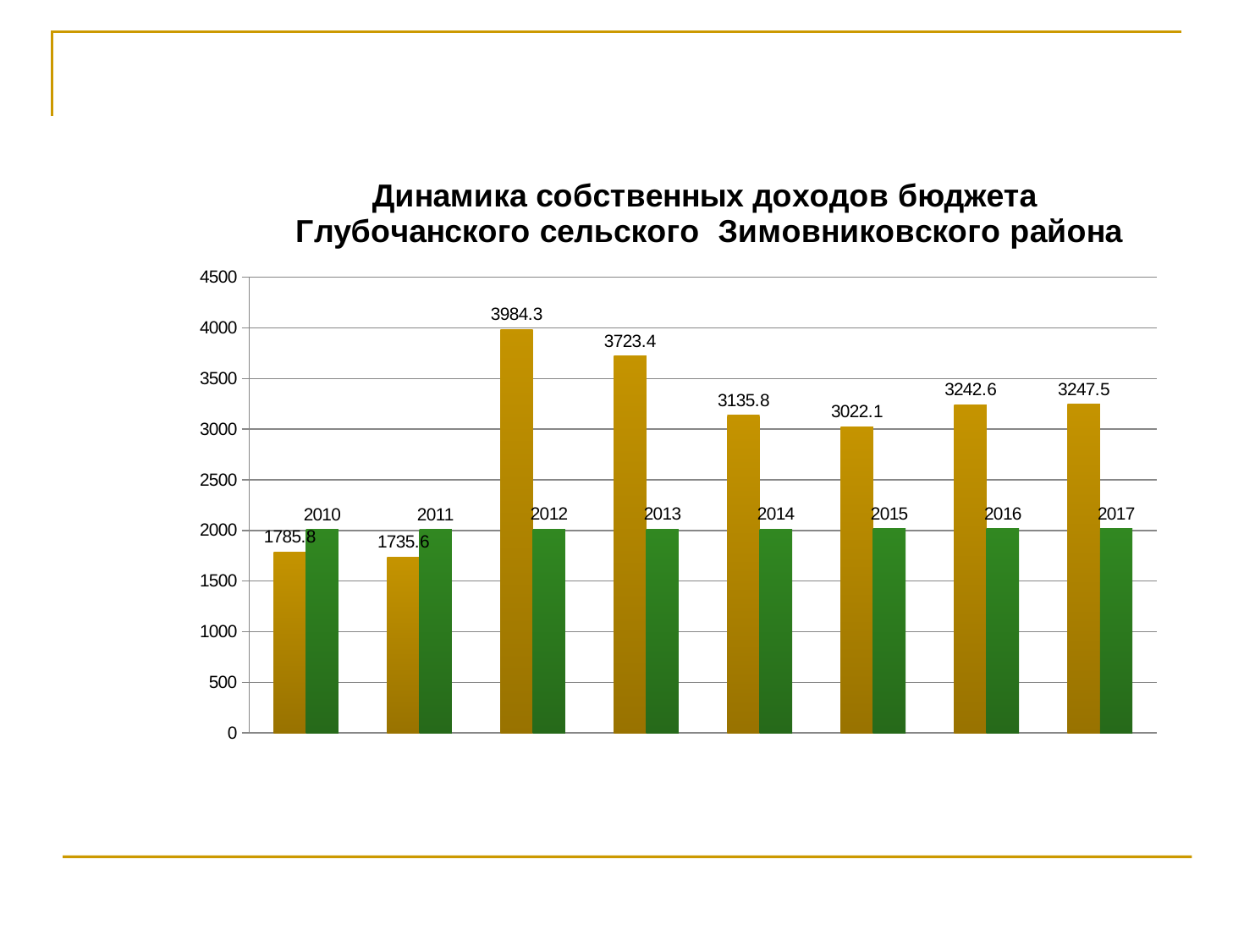
In which year group is the gold bar the lowest? 2011 How many year groups are plotted on the chart? 8 What value is printed on the gold bar in the 2010 group? 1785.8 What value is printed on the gold bar in the 2012 group? 3984.3 In which year group is the gold bar the highest? 2012 What value is printed on the gold bar in the 2015 group? 3022.1 Which gold bar is larger, the one for 2013 or the one for 2014? 2013 What is the title of the chart? Динамика собственных доходов бюджета Глубочанского сельского Зимовниковского района What value is printed on the gold bar in the 2017 group? 3247.5 What kind of chart is shown on the slide? bar chart What is the difference between the gold bar values for 2012 and 2013? 260.9 Do the gold bar values rise or fall from 2012 to 2015? fall